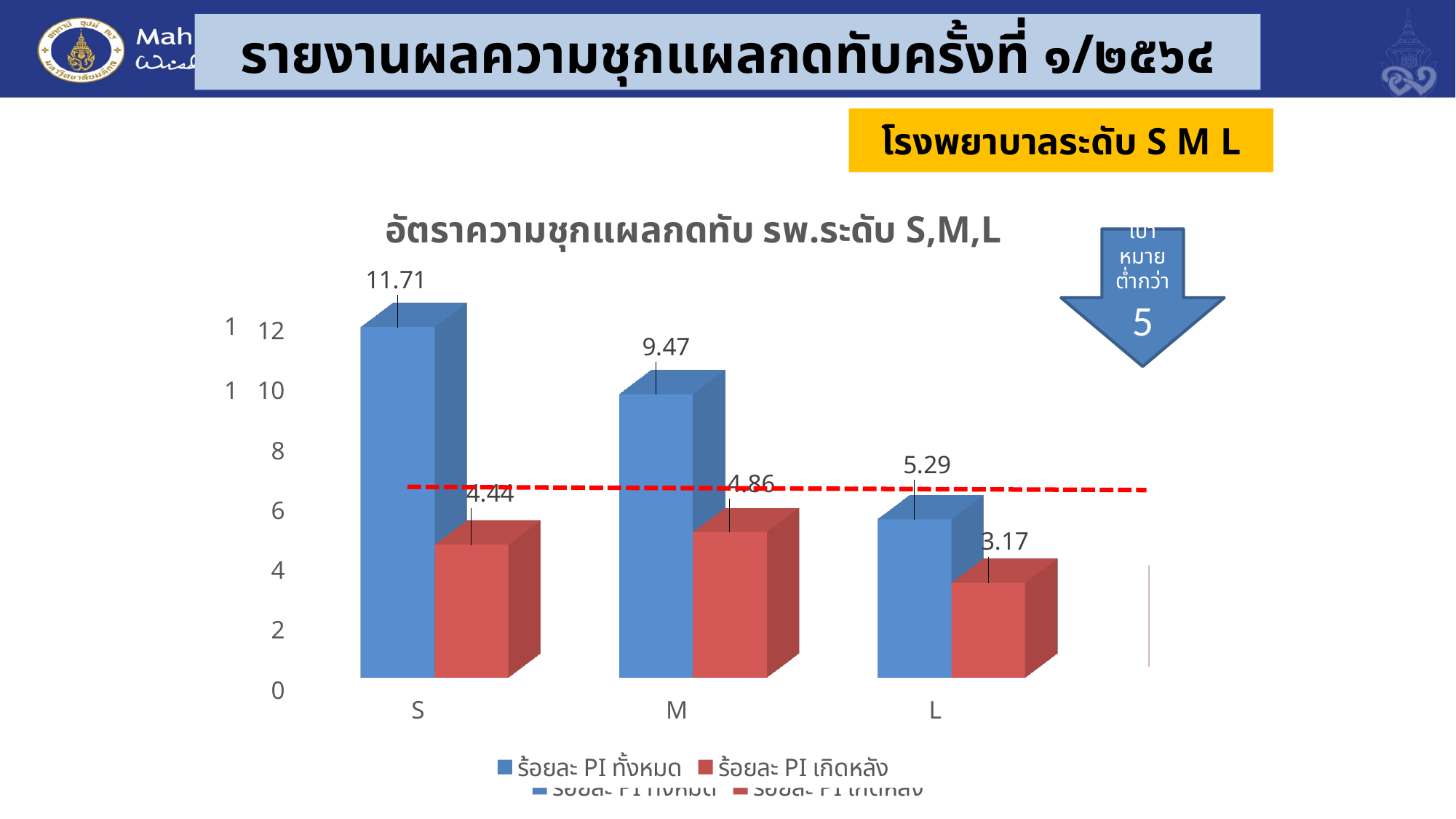
What kind of chart is shown on the slide? Bar chart What is the value of ร้อยละ PI ทั้งหมด for category L? 5.29 What is the value of ร้อยละ PI เกิดหลัง for category M? 4.86 Do the values for ร้อยละ PI ทั้งหมด rise or fall from S to L? Fall Which category has the lowest value for ร้อยละ PI เกิดหลัง? L How many categories are shown on the x axis? 3 Which is larger: ร้อยละ PI เกิดหลัง for S or for M? M What is the difference between ร้อยละ PI ทั้งหมด and ร้อยละ PI เกิดหลัง for category S? 7.27 What is the value of ร้อยละ PI เกิดหลัง for category L? 3.17 How many series does the legend list? 2 What is the value of ร้อยละ PI ทั้งหมด for category S? 11.71 Which category has the highest value for ร้อยละ PI ทั้งหมด? S